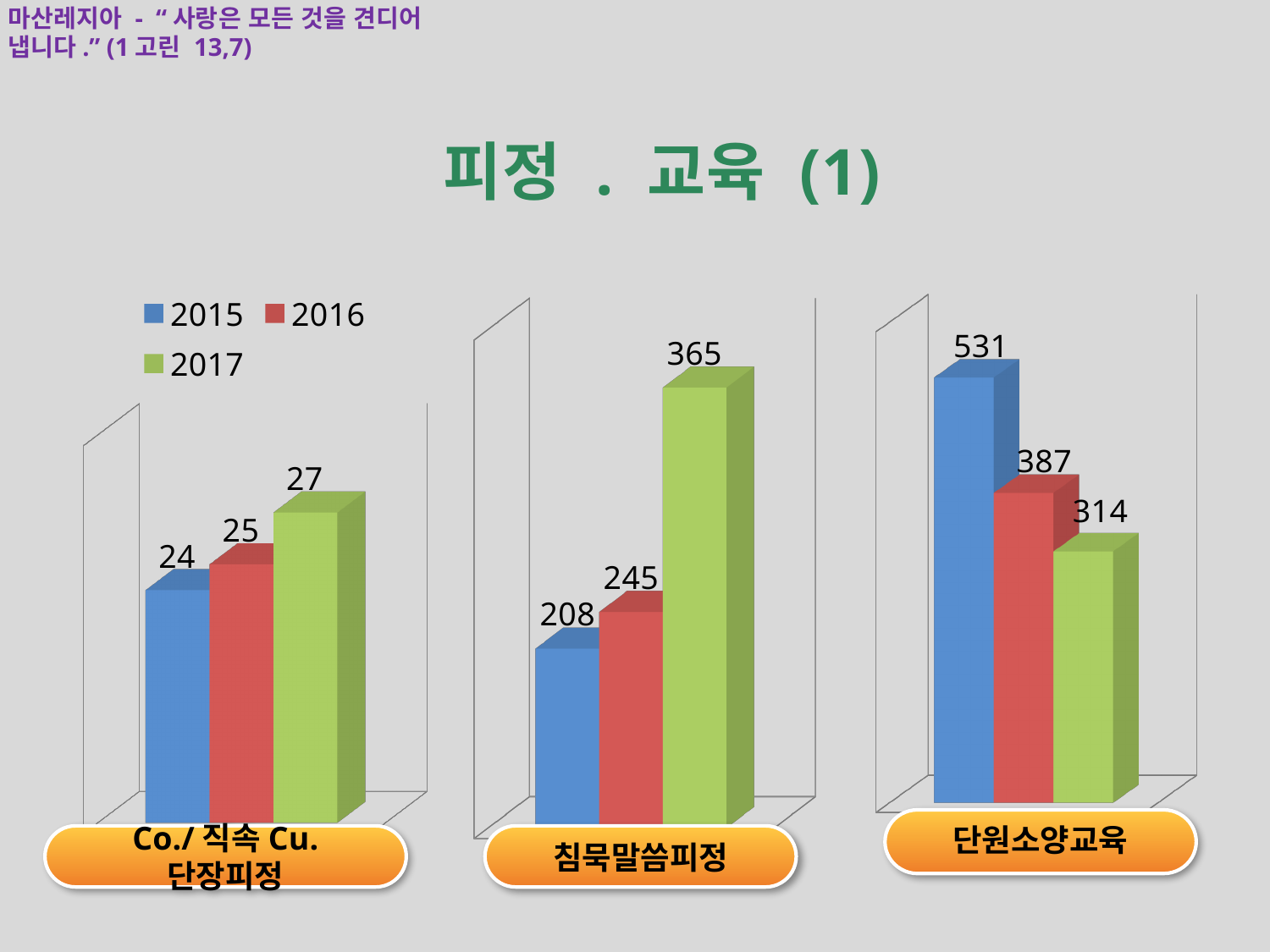
In the 침묵말씀피정 chart, what is the value for 2017? 365 In the Co./ 직속 Cu. 단장피정 chart, what is the value for 2016? 25 In the 단원소양교육 chart, what is the value for 2015? 531 In the 단원소양교육 chart, do the values rise or fall from 2015 to 2017? Fall In the 침묵말씀피정 chart, what is the difference between the 2017 and 2015 values? 157 Which colour represents 2017 in the legend? Green In the 침묵말씀피정 chart, which year has the highest value? 2017 What kind of chart is the 침묵말씀피정 chart? Bar chart In the 단원소양교육 chart, what is the difference between the 2015 and 2016 values? 144 In the 단원소양교육 chart, which is larger, the value for 2016 or the value for 2017? 2016 In the 단원소양교육 chart, which year has the lowest value? 2017 How many series does the legend on the slide list? 3